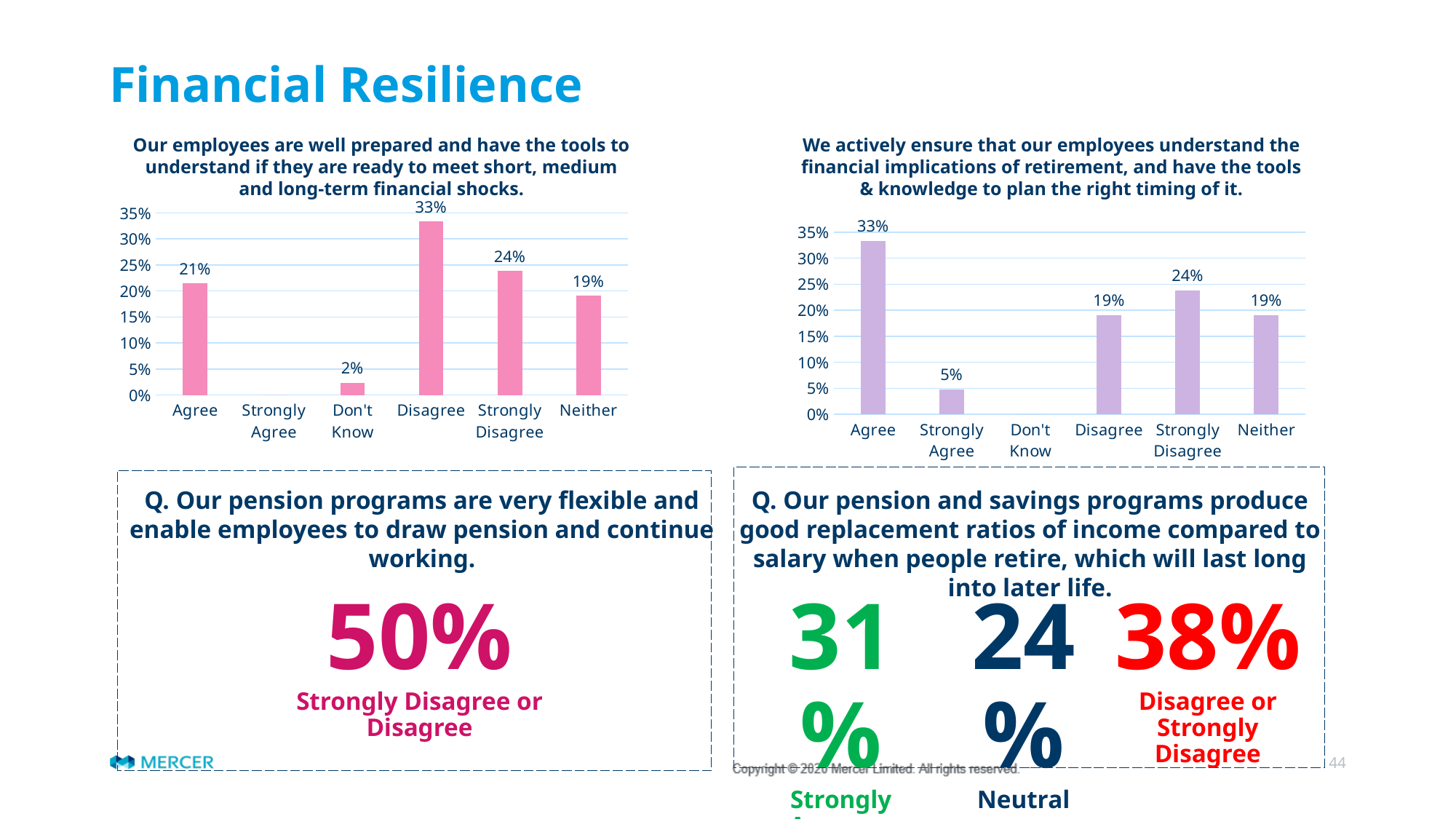
In the left chart ("Our employees are well prepared..."), which is larger, Strongly Disagree or Neither? Strongly Disagree In the right chart ("We actively ensure..."), is the value for Agree greater or less than 30%? greater What type of chart is the left chart ("Our employees are well prepared...")? Bar chart In the left chart ("Our employees are well prepared..."), what is the value for Don't Know? 2% In the left chart ("Our employees are well prepared..."), what is the value for Disagree? 33% In the right chart ("We actively ensure..."), what is the value for Strongly Agree? 5% How many categories are shown on the x axis of the right chart ("We actively ensure...")? 6 In the right chart ("We actively ensure..."), which category has the highest value? Agree In the left chart ("Our employees are well prepared..."), which category has the highest value? Disagree In the left chart ("Our employees are well prepared..."), what is the difference between Disagree and Agree? 12% In the right chart ("We actively ensure..."), what is the difference between Agree and Strongly Disagree? 9% What colour are the bars in the right chart ("We actively ensure...")? Light purple